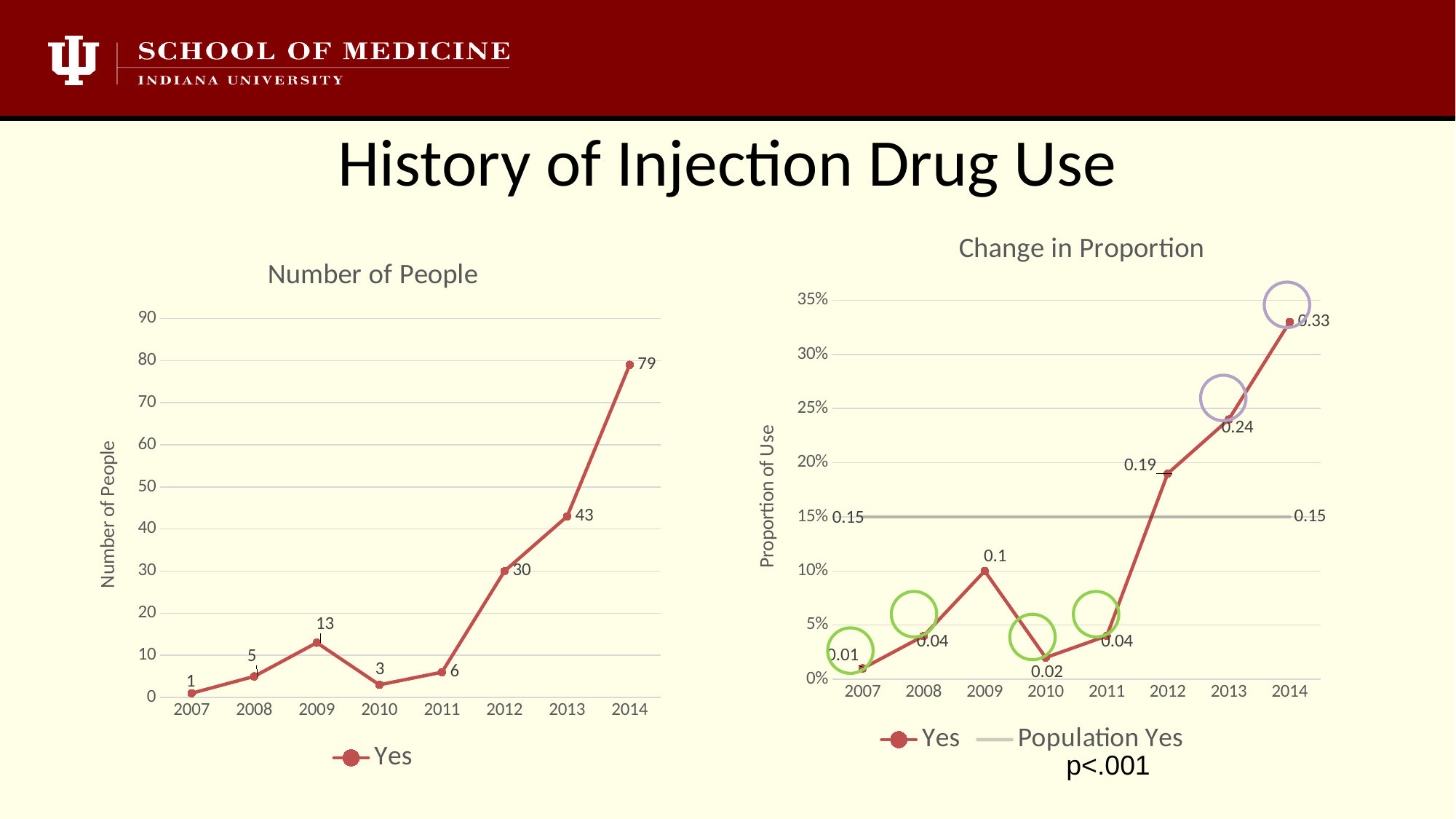
In the "Change in Proportion" chart, how many series does the legend list? 2 In the "Number of People" chart, what is the value for 2009? 13 In the "Number of People" chart, what kind of chart is shown? line chart In the "Change in Proportion" chart, is the Yes value for 2012 larger or smaller than the Population Yes value? larger In the "Change in Proportion" chart, what is the value of the Yes series for 2010? 0.02 In the "Number of People" chart, what is the value for 2014? 79 In the "Change in Proportion" chart, which year has the highest Yes value? 2014 In the "Number of People" chart, what is the difference between the values for 2014 and 2013? 36 In the "Change in Proportion" chart, what is the label of the y axis? Proportion of Use In the "Number of People" chart, which year has the lowest value? 2007 In the "Change in Proportion" chart, what is the value of the Yes series for 2013? 0.24 In the "Number of People" chart, how many years are plotted on the x axis? 8